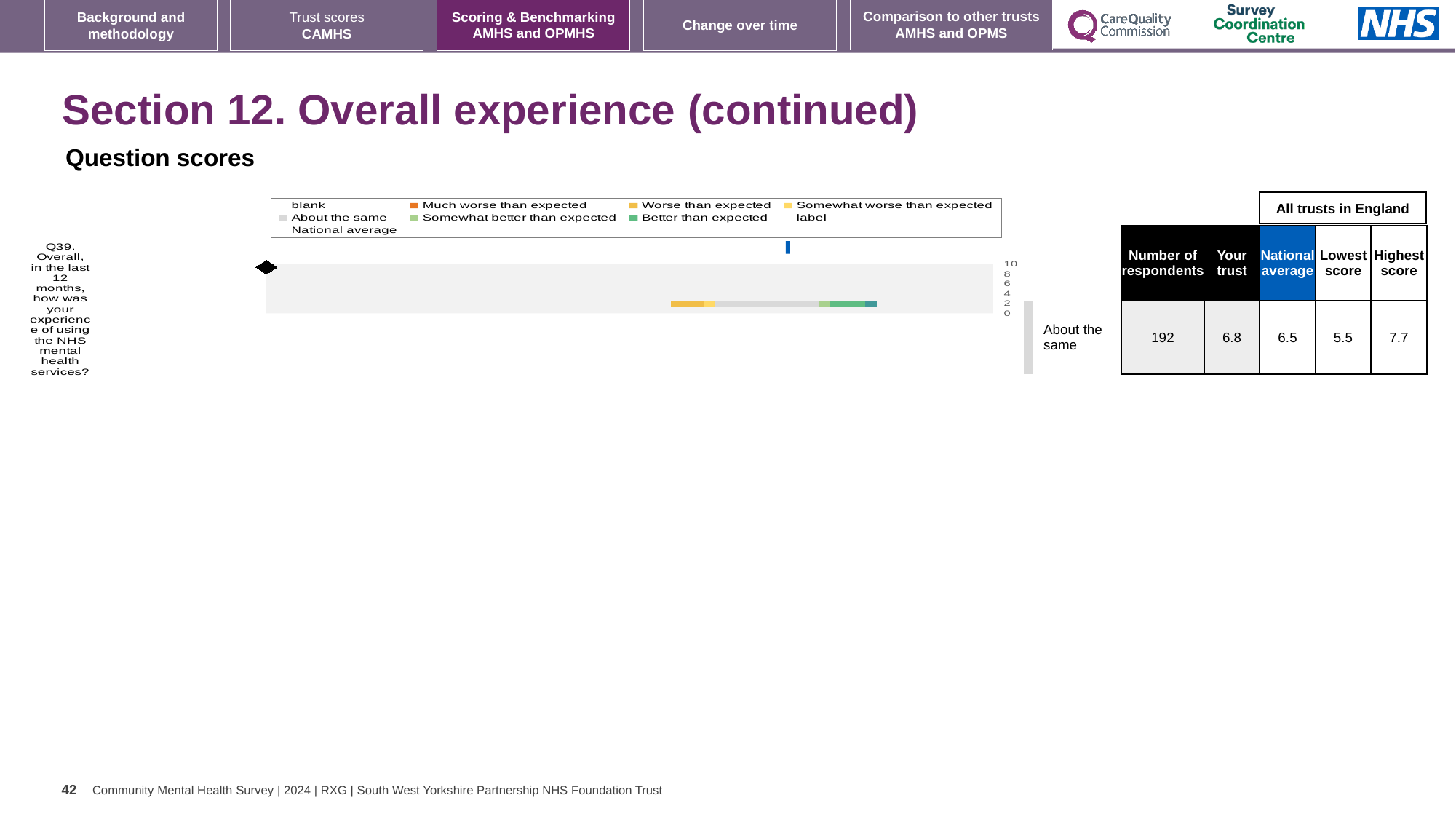
Which is larger for Q39, the 'Your trust' score or the national average? Your trust What is the lowest score among all trusts in England for Q39? 5.5 What benchmark category label is shown next to the chart for Q39? About the same What is the difference between the 'Your trust' score and the national average for Q39? 0.3 Which question number is plotted on the chart? Q39 What is the highest score among all trusts in England for Q39? 7.7 What is the national average score for Q39? 6.5 What kind of chart is used to show the Q39 question score? bar chart What is the difference between the highest score and the lowest score for Q39? 2.2 What is the 'Your trust' score for Q39? 6.8 How many respondents answered Q39? 192 How many survey questions are plotted on the chart? 1